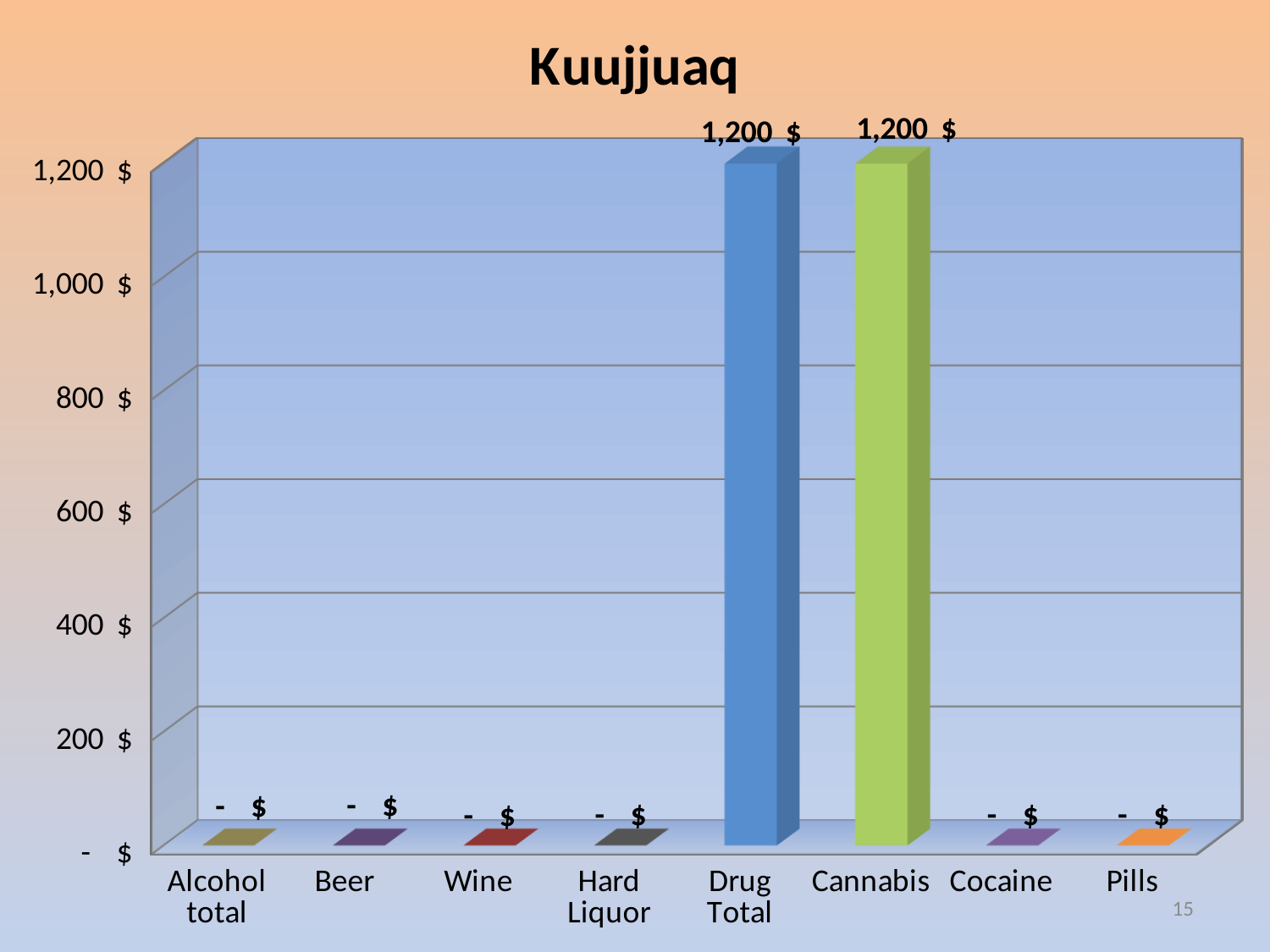
What is the value shown for Beer? - $ How many categories are shown on the x axis? 8 Is the value for Drug Total greater or less than 1,000 $? greater What is the difference between the value for Drug Total and the value for Cannabis? - $ What is the value for Cannabis? 1,200 $ What is the title of the chart? Kuujjuaq What is the value shown for Alcohol total? - $ What colour is the Cannabis bar? green What kind of chart is shown on the slide? bar chart Which is larger, the value for Cannabis or the value for Cocaine? Cannabis Which is larger, the value for Drug Total or the value for Wine? Drug Total What is the value for Drug Total? 1,200 $